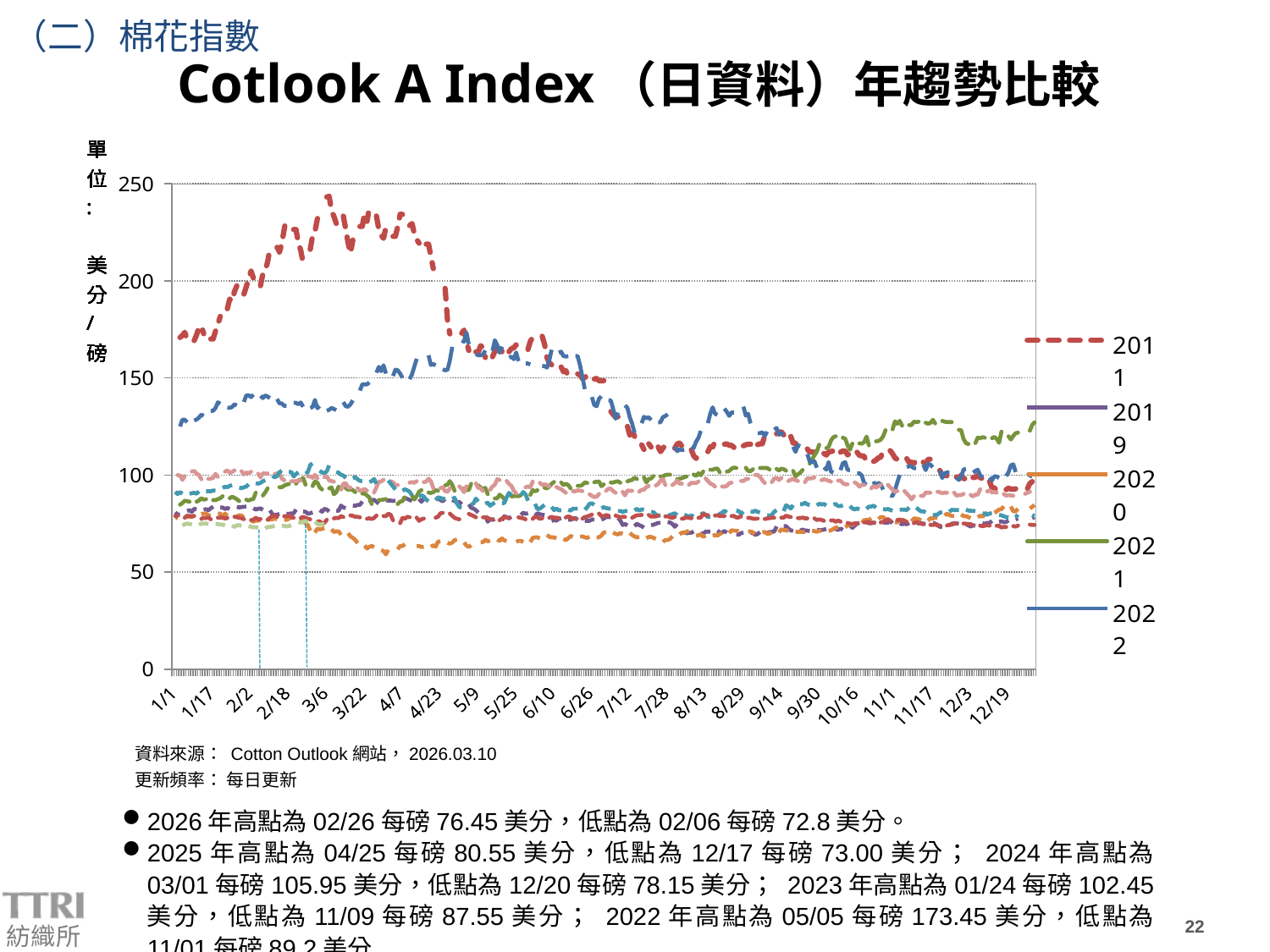
Around 3/6, which series has the larger value, 2011 or 2020? 2011 Does the 2020 series rise or fall from 4/7 to 12/19? rise What kind of chart is shown on the slide? line chart Is the value of the 2011 series at 1/1 greater or less than 150? greater Is the value of the 2020 series around 4/7 greater or less than 100? less Which series reaches the highest value on the chart? 2011 What unit is shown on the y axis of the chart? 美分/磅 What is the title of the chart? Cotlook A Index （日資料）年趨勢比較 Does the 2011 series rise or fall from 3/6 to 12/19? fall Is the peak value of the 2022 series greater or less than 150? greater